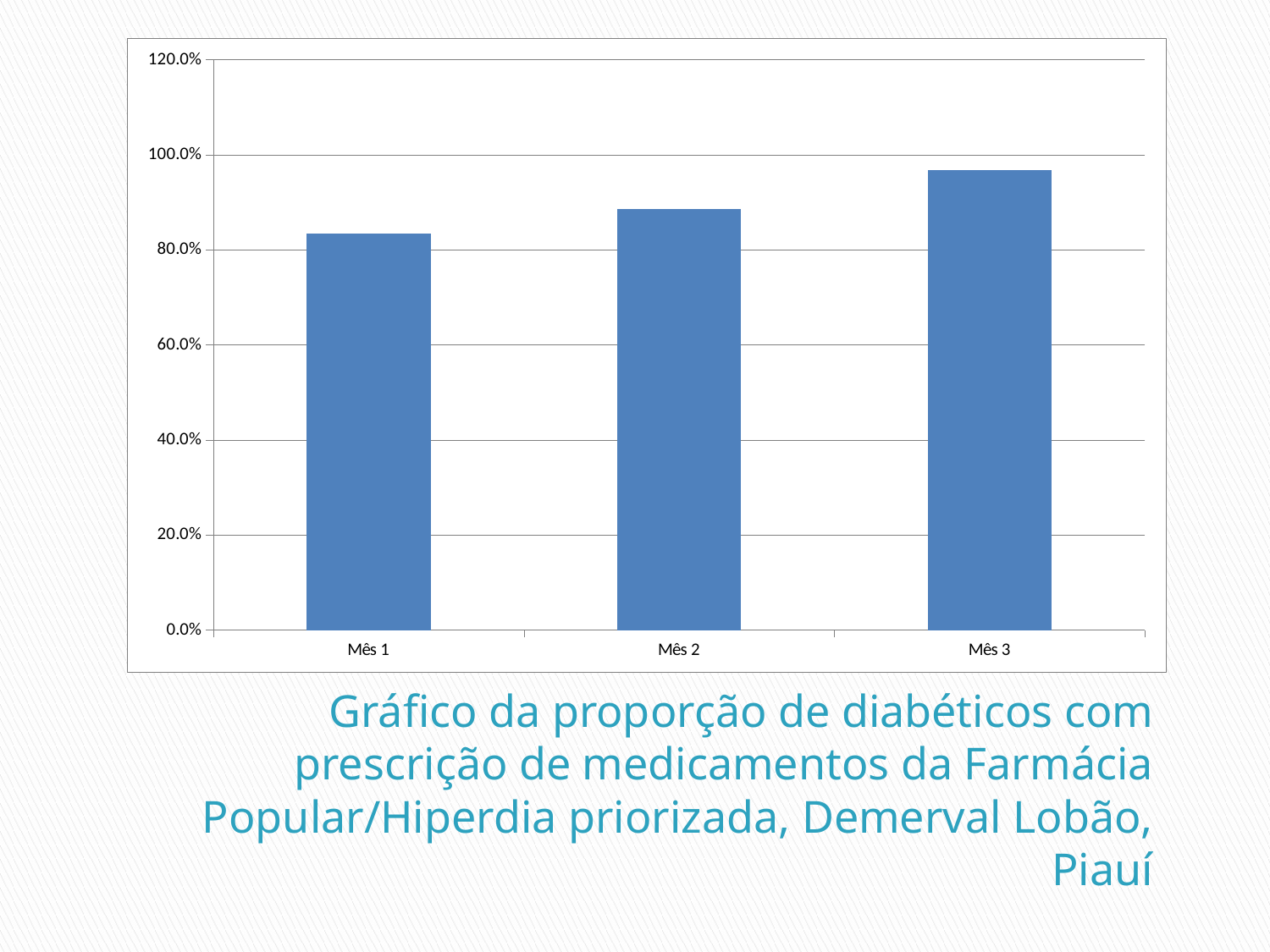
Is the value for Mês 2 greater or less than 80.0%? greater Which month has the lowest bar? Mês 1 Which is larger, the value for Mês 1 or the value for Mês 3? Mês 3 How many categories (months) are plotted on the x axis? 3 Is the value for Mês 1 greater or less than 80.0%? greater Is the value for Mês 2 greater or less than 100.0%? less Do the values rise or fall from Mês 1 to Mês 3? rise Which month has the highest bar? Mês 3 What kind of chart is shown on the slide? bar chart What colour are the bars in the chart? blue What is the highest value shown on the vertical axis? 120.0%